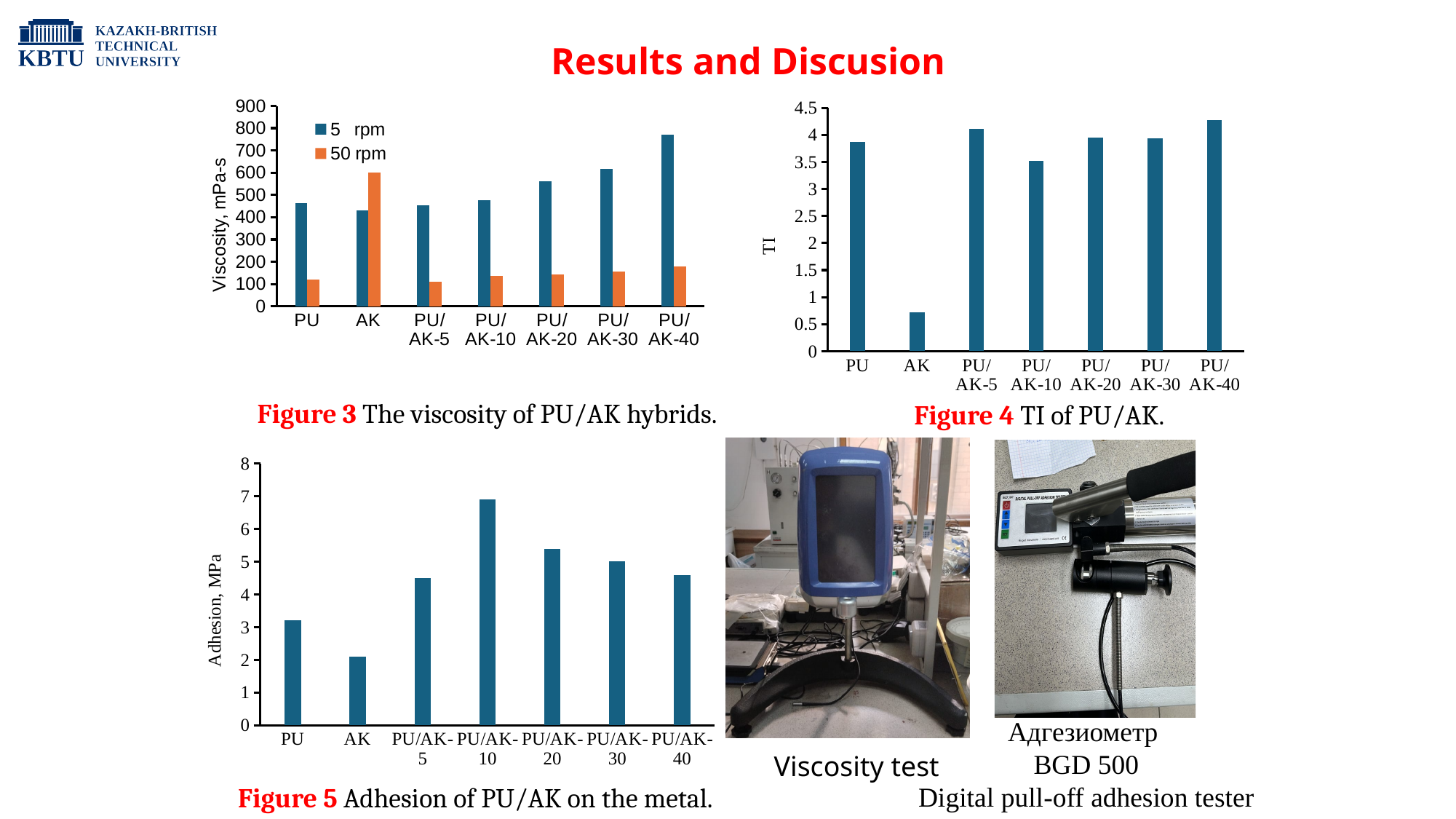
In Figure 5 (adhesion chart), is the adhesion for PU/AK-10 greater or less than 6? greater In Figure 5 (adhesion chart), which category has the highest adhesion? PU/AK-10 In Figure 3 (viscosity chart), which category has the highest 5 rpm viscosity? PU/AK-40 In Figure 4 (TI chart), which category has the lowest TI? AK In Figure 4 (TI chart), is the TI for AK greater or less than 1? less In Figure 3 (viscosity chart), for AK, which is larger: the 5 rpm or the 50 rpm viscosity? 50 rpm In Figure 3 (viscosity chart), which category has the highest 50 rpm viscosity? AK In Figure 5 (adhesion chart), how many categories are shown on the x axis? 7 In Figure 3 (viscosity chart), is the 5 rpm viscosity for PU/AK-40 greater or less than 700? greater In Figure 3 (viscosity chart), how many series does the legend list? 2